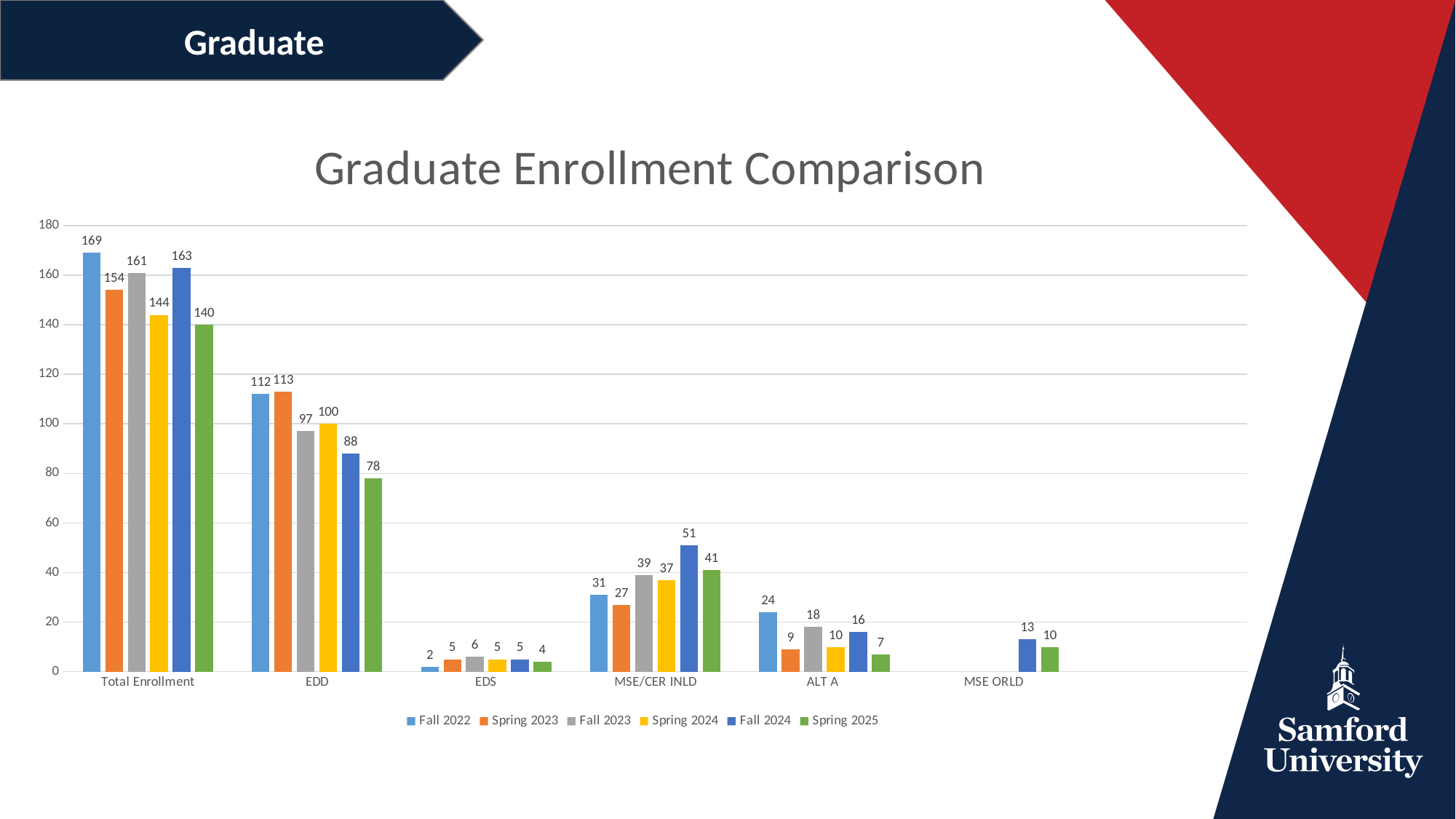
How many series does the legend list? 6 What is the ALT A value for Spring 2023? 9 How many categories are shown on the x axis? 6 What is the difference between the Fall 2022 and Spring 2025 values for Total Enrollment? 29 What is the MSE/CER INLD value for Fall 2024? 51 What kind of chart is shown on the slide? Bar chart What is the Total Enrollment value for Fall 2022? 169 Which series has the highest Total Enrollment value? Fall 2022 What is the EDD value for Spring 2025? 78 Which is larger for EDD: the Fall 2023 value or the Spring 2024 value? Spring 2024 Which series has the lowest EDS value? Fall 2022 What is the title of the chart? Graduate Enrollment Comparison